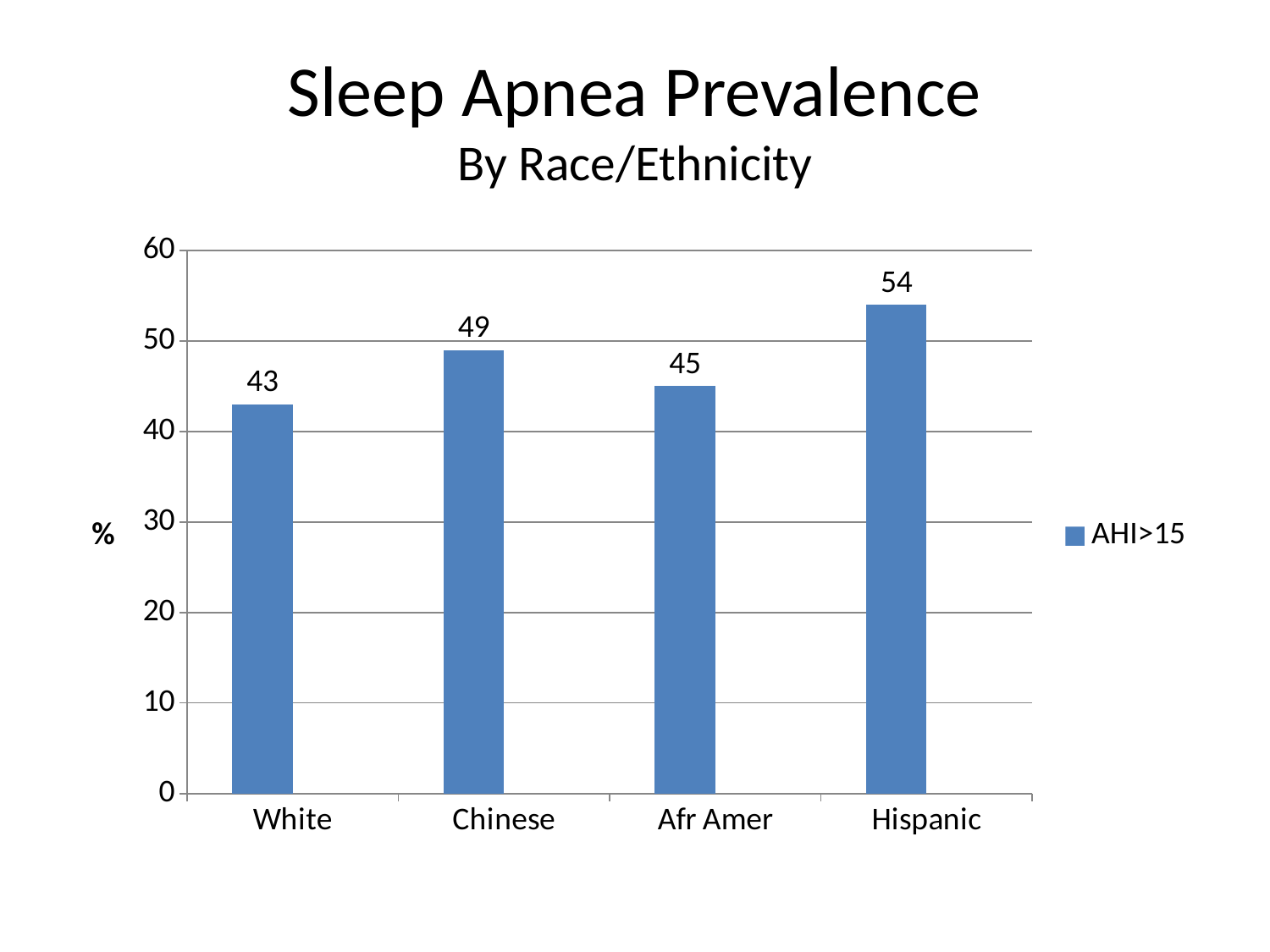
What is the value for Afr Amer? 45 Is the value for Hispanic greater or less than 50? greater What is the value for Hispanic? 54 Which is larger, the value for Chinese or the value for Afr Amer? Chinese What is the value for White? 43 What is the value for Chinese? 49 What is the difference between the values for Hispanic and White? 11 How many categories are shown on the x axis? 4 What kind of chart is shown? bar chart What series does the legend list? AHI>15 Which category has the highest value? Hispanic Which category has the lowest value? White